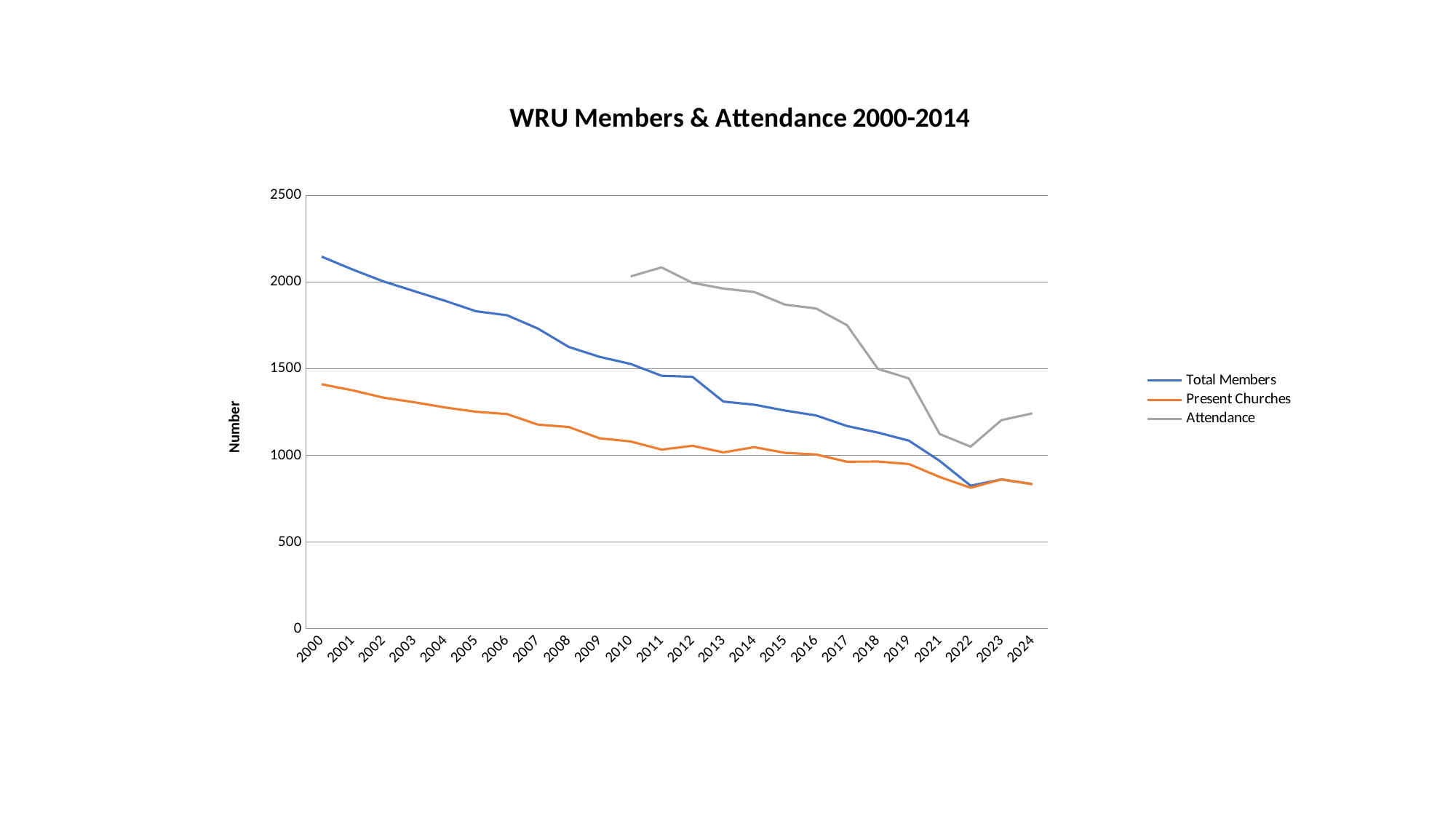
What is the label on the vertical axis? Number Is the value for Total Members in 2000 greater or less than 2000? greater What kind of chart is shown on the slide? line chart Which series has the lowest value in 2019? Present Churches In 2015, which is larger: Attendance or Total Members? Attendance Is the value for Total Members in 2022 greater or less than 1000? less Is the value for Attendance in 2011 greater or less than 2000? greater How many series does the legend list? 3 What is the title of the chart? WRU Members & Attendance 2000-2014 How many years are shown on the x axis? 24 Does the Total Members line rise or fall from 2000 to 2022? fall